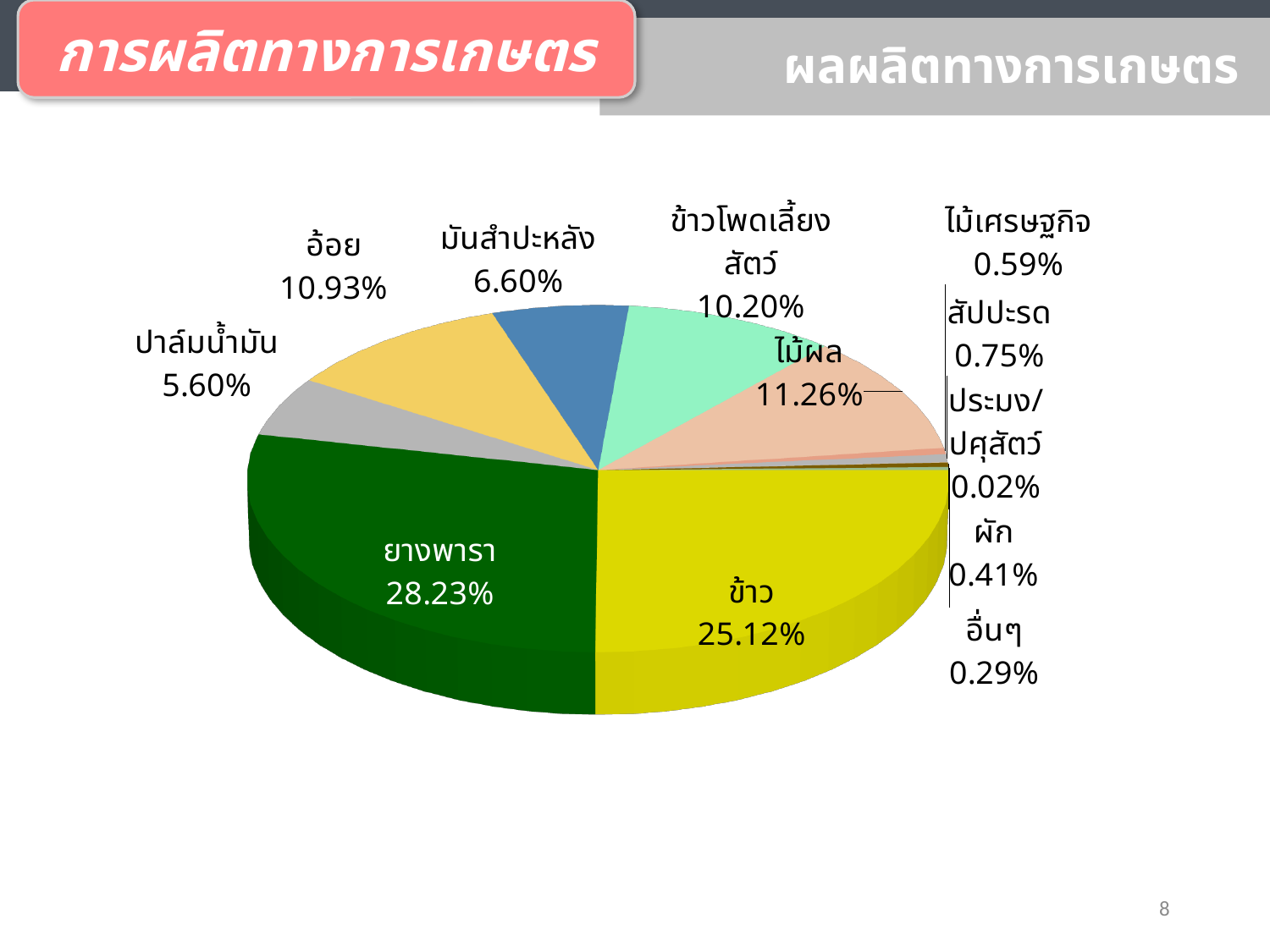
What is the share for ประมง/ปศุสัตว์? 0.02% What is the share for ยางพารา? 28.23% Which has a larger share, อ้อย or ข้าวโพดเลี้ยงสัตว์? อ้อย What is the share for ข้าว? 25.12% What is the share for ไม้ผล? 11.26% What is the difference between the shares of ยางพารา and ข้าว? 3.11% Which category has the largest share of the pie? ยางพารา Which category has the smallest share of the pie? ประมง/ปศุสัตว์ How many categories are shown in the pie chart? 12 What type of chart is shown on the slide? pie chart What is the share for ปาล์มน้ำมัน? 5.60% What is the title shown in the header above the chart? ผลผลิตทางการเกษตร